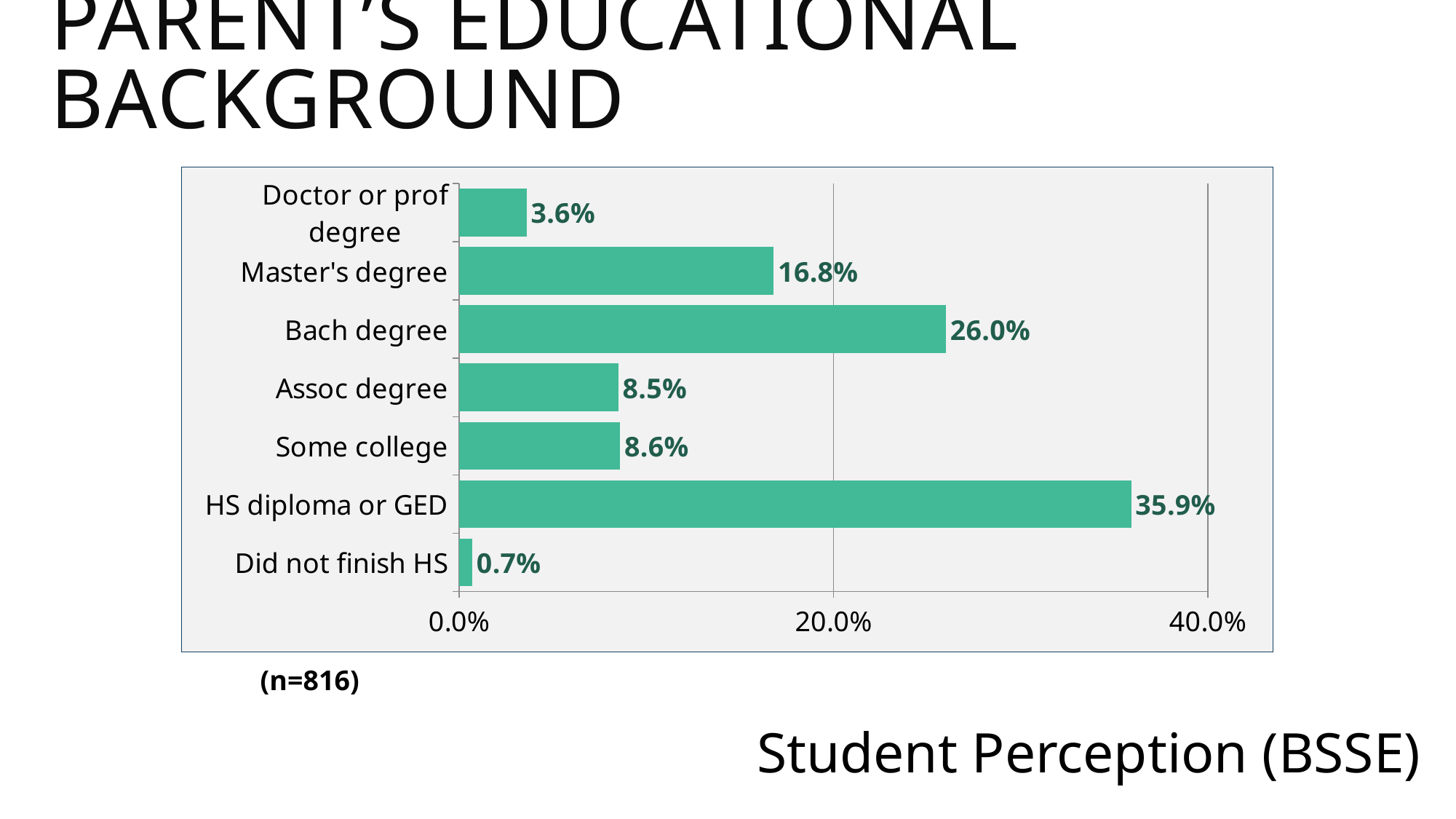
What percentage of parents have a Bach degree? 26.0% Is the value for Bach degree greater or less than 20.0%? greater What kind of chart is shown on the slide? Bar chart Which category has the highest value? HS diploma or GED What is the difference between the values for HS diploma or GED and Bach degree? 9.9% What percentage is shown for Did not finish HS? 0.7% What is the value for Master's degree? 16.8% How many categories are shown in the chart? 7 Which category has the lowest value? Did not finish HS Which is larger, the value for Master's degree or the value for Assoc degree? Master's degree What sample size is noted below the chart? n=816 What is the value shown for HS diploma or GED? 35.9%